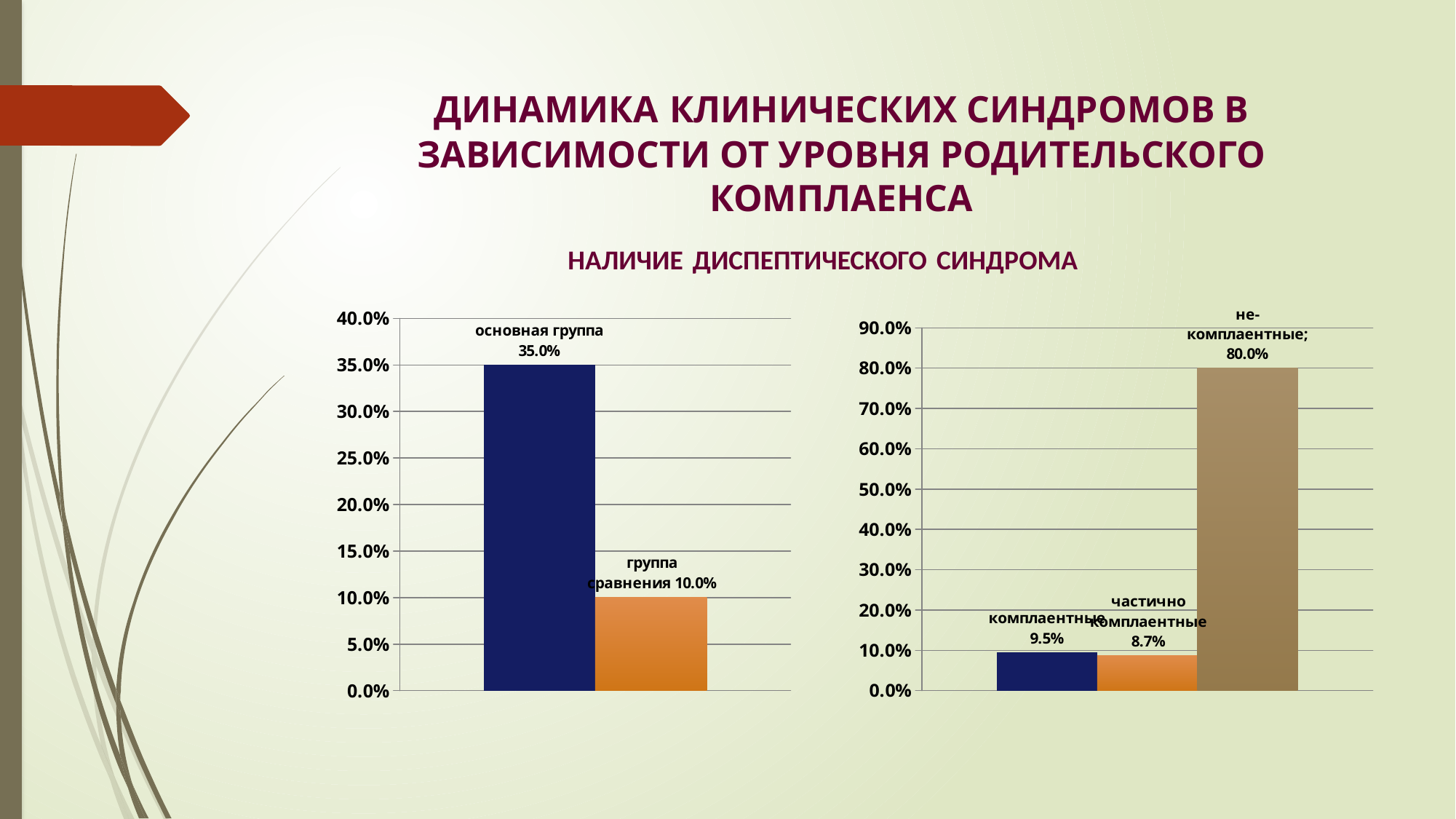
In the left chart, what is the value for группа сравнения? 10.0% What type of chart is the right chart? bar chart In the right chart, which category has the highest value? не-комплаентные In the right chart, what is the difference between не-комплаентные and комплаентные? 70.5% In the right chart, what is the value for не-комплаентные? 80.0% In the left chart, what is the difference between основная группа and группа сравнения? 25.0% How many bars are shown in the left chart? 2 How many categories are shown in the right chart? 3 In the right chart, what is the value for частично комплаентные? 8.7% In the left chart, which group has the higher value? основная группа In the right chart, what is the value for комплаентные? 9.5% In the left chart, what is the value for основная группа? 35.0%